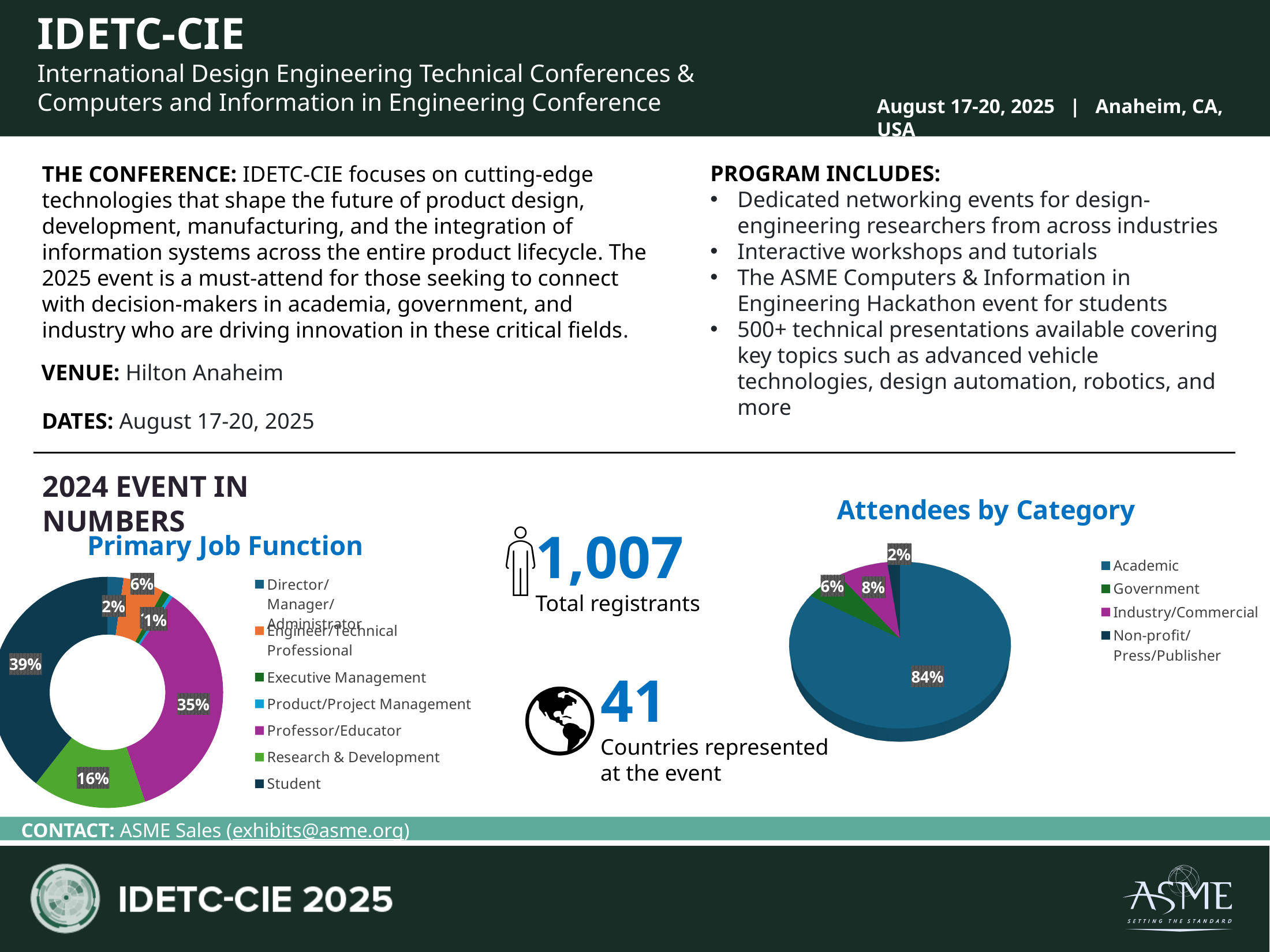
In the Primary Job Function chart, what percentage are Professor/Educator? 35% In the Attendees by Category chart, how many categories does the legend list? 4 In the Primary Job Function chart, what percentage are Students? 39% In the Attendees by Category chart, what percentage is Government? 6% In the Attendees by Category chart, which category has the smallest share? Non-profit/Press/Publisher In the Attendees by Category chart, what percentage of attendees are Academic? 84% In the Primary Job Function chart, which job function has the largest share? Student In the Primary Job Function chart, which is larger: Research & Development or Engineer/Technical Professional? Research & Development In the Attendees by Category chart, what is the difference between the Academic and Industry/Commercial shares? 76% In the Primary Job Function chart, what percentage are Research & Development? 16% In the Attendees by Category chart, what share is Industry/Commercial? 8% What type of chart is the Attendees by Category chart? Pie chart